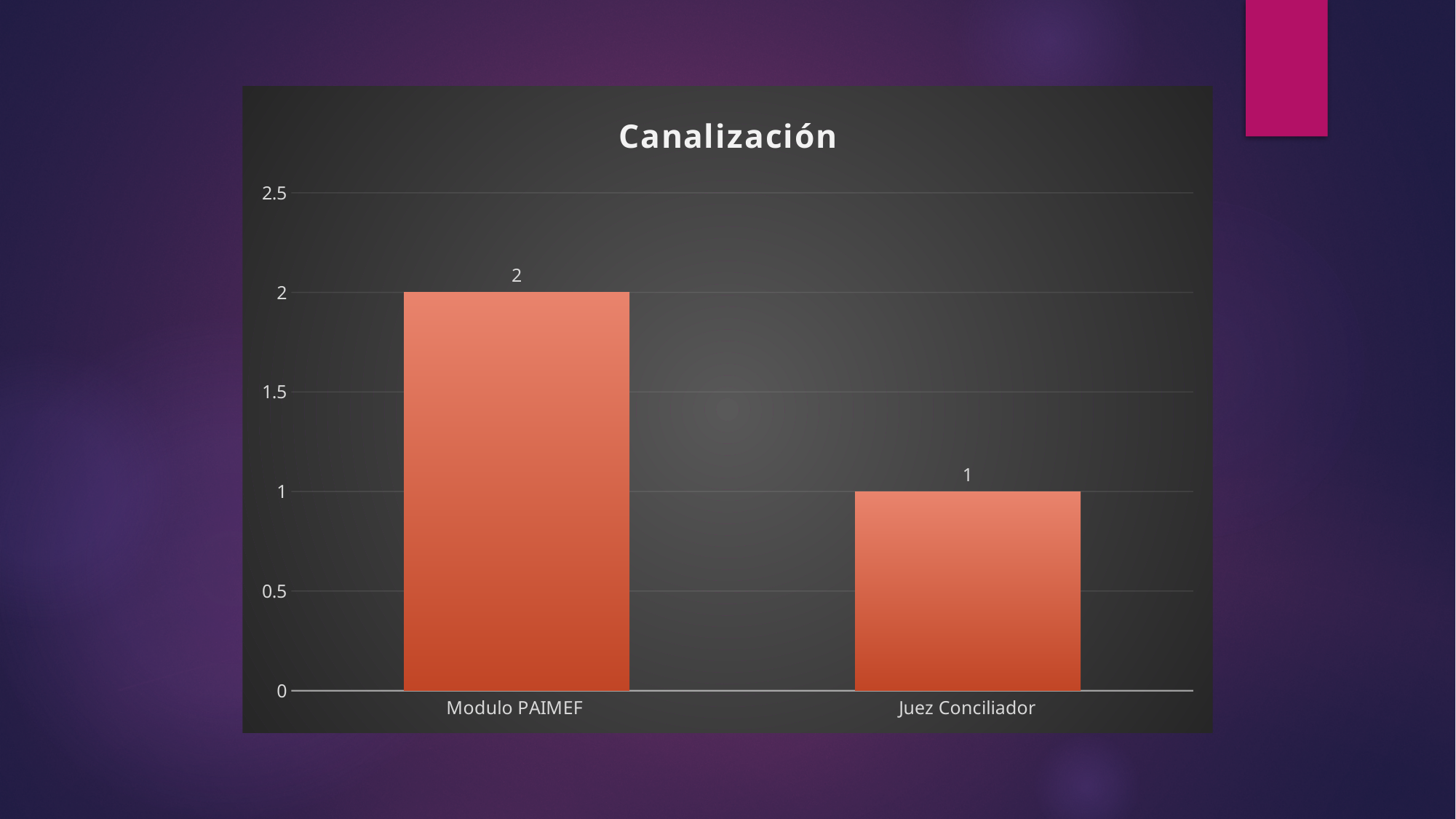
Which category has the highest value? Modulo PAIMEF What is the value for Modulo PAIMEF? 2 What is the difference between the values for Modulo PAIMEF and Juez Conciliador? 1 Is the value for Juez Conciliador greater or less than 1.5? less Which is larger, the value for Modulo PAIMEF or the value for Juez Conciliador? Modulo PAIMEF How many categories are shown on the x axis? 2 Is the value for Modulo PAIMEF greater or less than 1.5? greater Which category has the lowest value? Juez Conciliador What is the title of the chart? Canalización What is the value for Juez Conciliador? 1 Do the values rise or fall from left to right along the x axis? fall What kind of chart is shown on the slide? bar chart